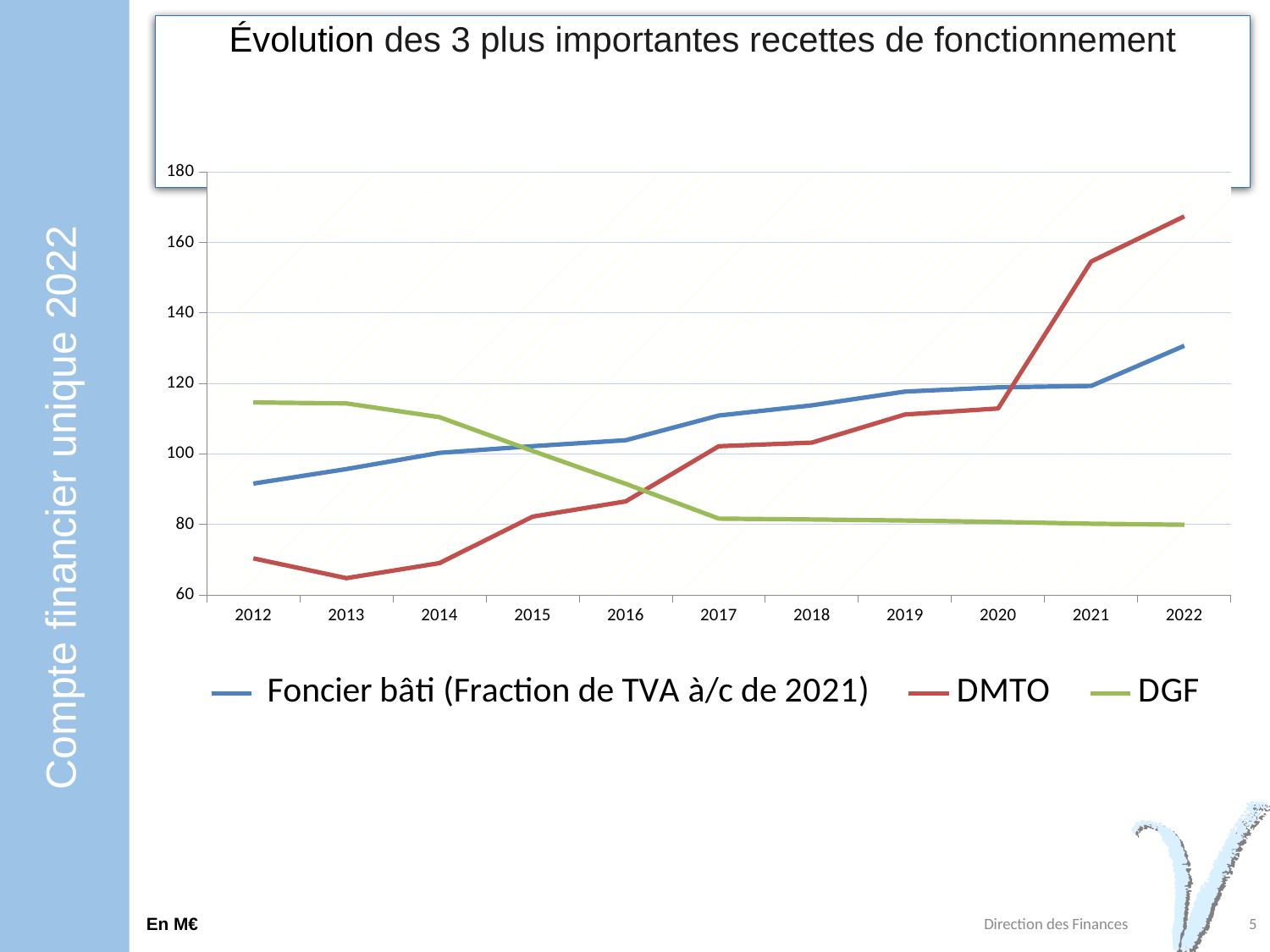
Is the DGF value for 2012 greater or less than 100? greater Is the DMTO value for 2022 greater or less than 160? greater Which series has the lowest value in 2012? DMTO In 2016, which is larger: Foncier bâti (Fraction de TVA à/c de 2021) or DMTO? Foncier bâti (Fraction de TVA à/c de 2021) Which series has the highest value in 2022? DMTO How many years are plotted along the x axis? 11 Does the DGF line rise or fall from 2012 to 2022? fall How many series does the legend list? 3 What kind of chart is shown on the slide? line chart What is the title of the chart? Évolution des 3 plus importantes recettes de fonctionnement Does the Foncier bâti (Fraction de TVA à/c de 2021) line rise or fall from 2012 to 2022? rise Is the DMTO value for 2013 greater or less than 80? less